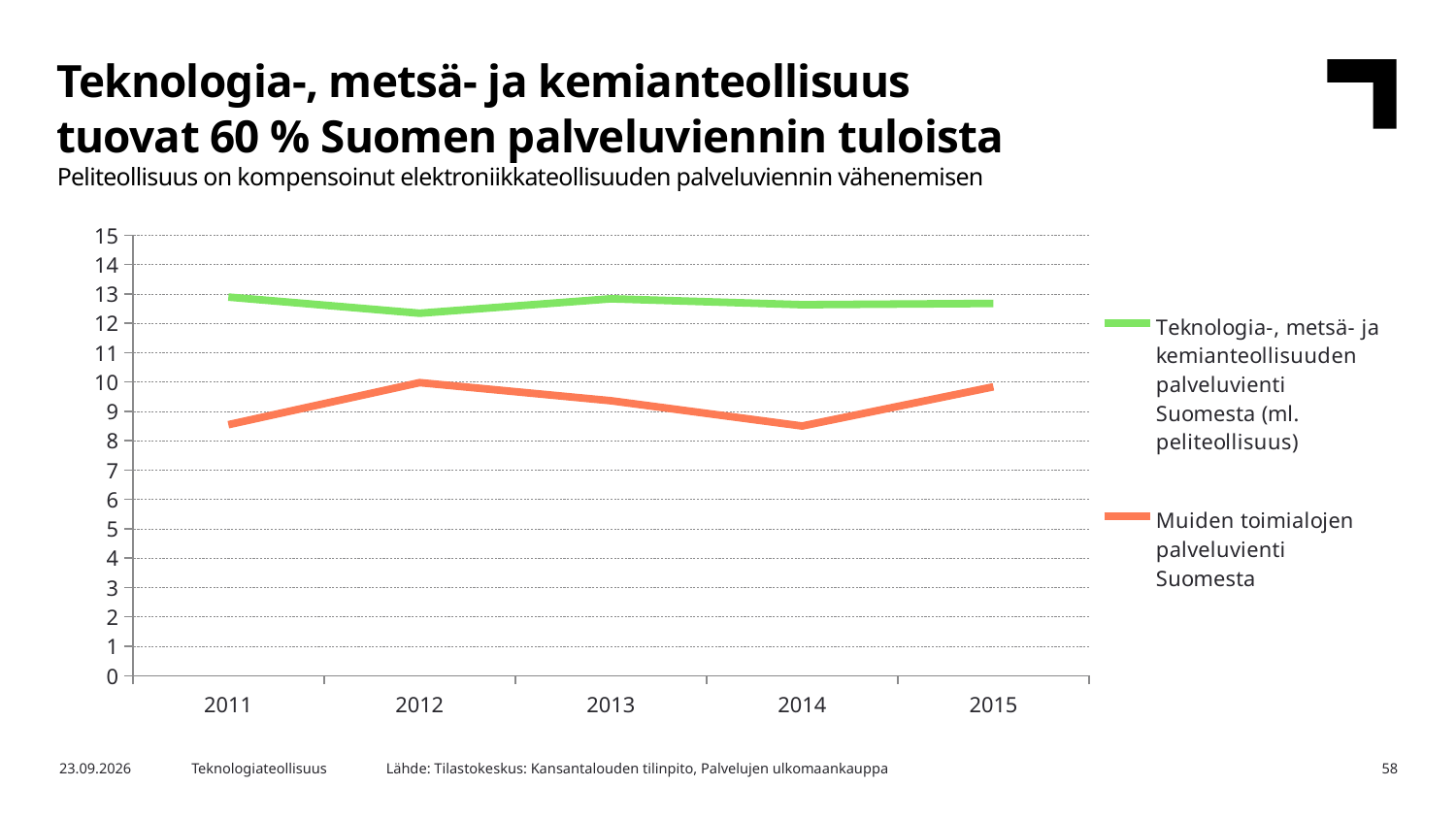
In which year is the value for Teknologia-, metsä- ja kemianteollisuuden palveluvienti Suomesta lowest? 2012 Is the value for Muiden toimialojen palveluvienti Suomesta in 2015 greater or less than 9? greater Does the value for Muiden toimialojen palveluvienti Suomesta rise or fall from 2011 to 2012? rise How many series does the legend list? 2 Which series has the higher value in 2013, Teknologia-, metsä- ja kemianteollisuuden palveluvienti Suomesta or Muiden toimialojen palveluvienti Suomesta? Teknologia-, metsä- ja kemianteollisuuden palveluvienti Suomesta How many years are plotted along the x axis? 5 Which colour is used for the Muiden toimialojen palveluvienti Suomesta line? orange What kind of chart is shown on the slide? line chart Is the value for Teknologia-, metsä- ja kemianteollisuuden palveluvienti Suomesta in 2012 greater or less than 12? greater Is the value for Teknologia-, metsä- ja kemianteollisuuden palveluvienti Suomesta in 2011 greater or less than 12? greater Does the value for Muiden toimialojen palveluvienti Suomesta rise or fall from 2012 to 2014? fall